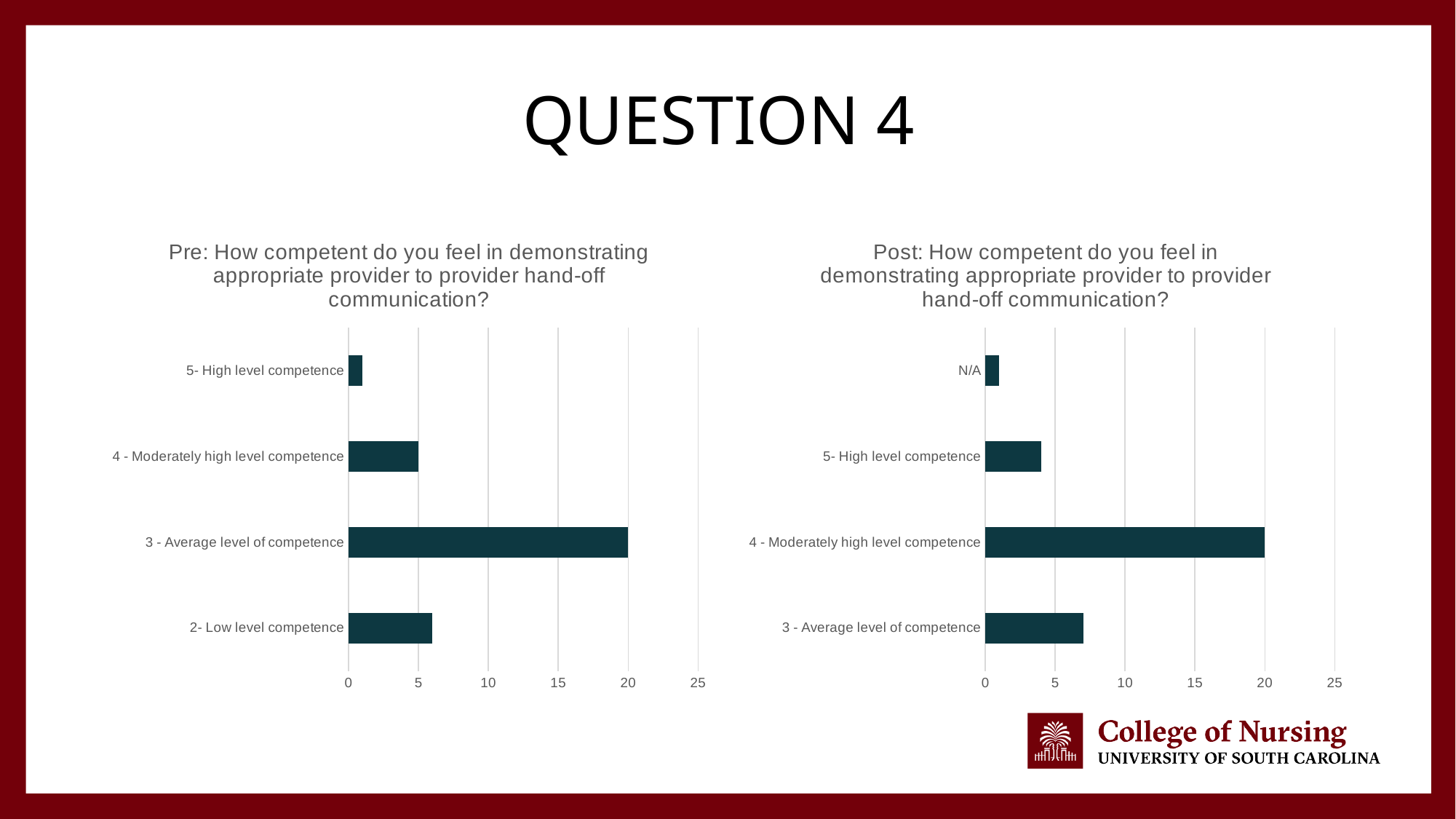
In the Post chart on the right, what is the value for 4 - Moderately high level competence? 20 What kind of chart is the Pre chart on the left? bar chart How many categories are shown in the Pre chart on the left? 4 In the Post chart on the right, is the value for 3 - Average level of competence greater or less than 10? less In the Pre chart on the left, is the value for 2- Low level competence greater or less than 10? less In the Pre chart on the left, what is the value for 4 - Moderately high level competence? 5 In the Post chart on the right, which category has the highest value? 4 - Moderately high level competence In the Pre chart on the left, which category has the highest value? 3 - Average level of competence In the Pre chart on the left, which category has the lowest value? 5- High level competence In the Post chart on the right, which category has the lowest value? N/A How many categories are shown in the Post chart on the right? 4 In the Pre chart on the left, what is the value for 3 - Average level of competence? 20